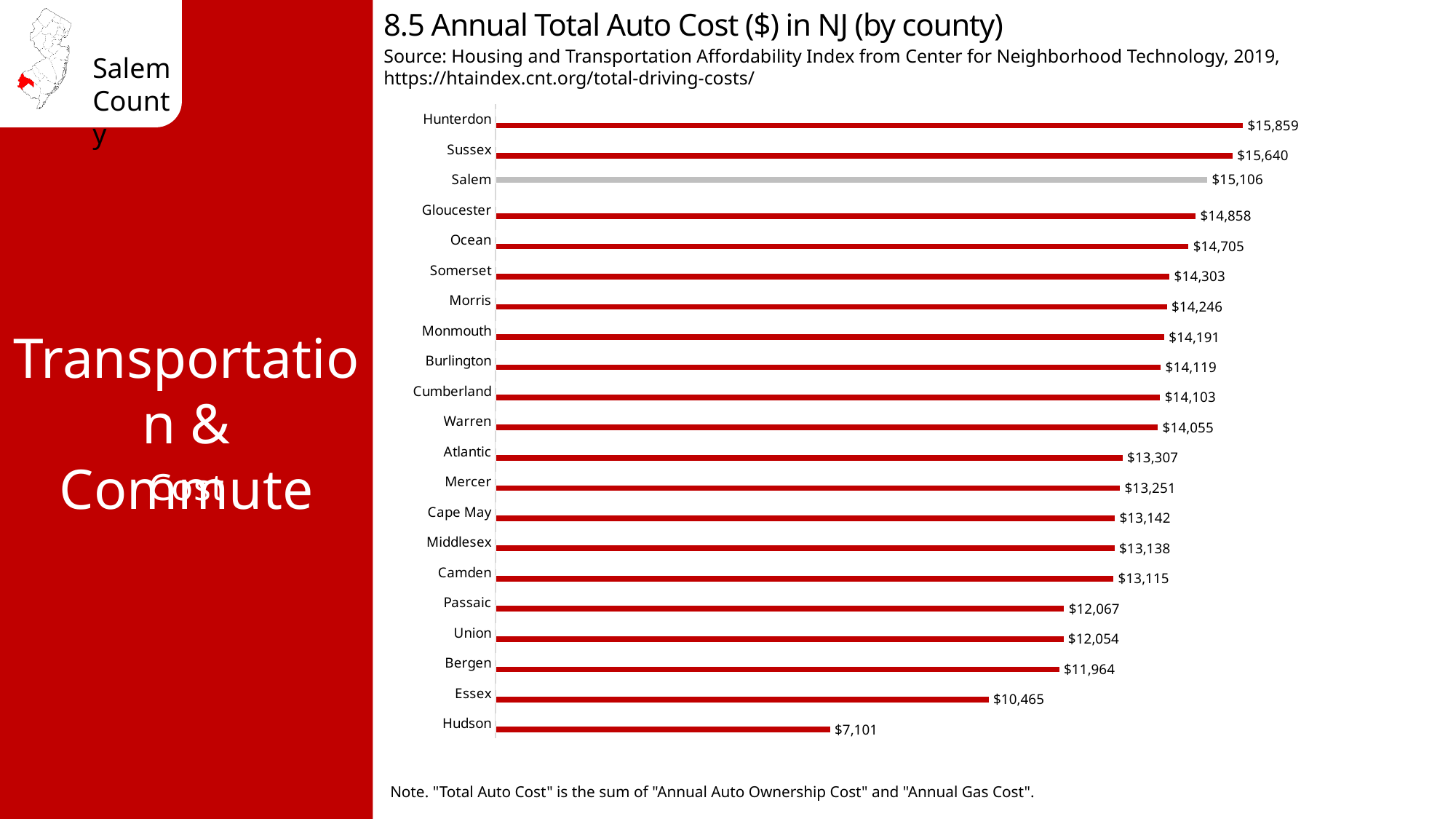
Which has a higher annual total auto cost, Essex or Bergen? Bergen Which county has the lowest annual total auto cost? Hudson What is the difference between the annual total auto cost in Hunterdon and Hudson? $8,758 Which county has the highest annual total auto cost? Hunterdon Which county's bar is shown in grey rather than red? Salem What is the annual total auto cost for Cape May County? $13,142 What is the title of the chart? 8.5 Annual Total Auto Cost ($) in NJ (by county) What is the annual total auto cost for Salem County? $15,106 What type of chart is used on this slide? Bar chart What is the annual total auto cost for Hudson County? $7,101 How much higher is Salem's annual total auto cost than Gloucester's? $248 How many counties are shown in the chart? 21